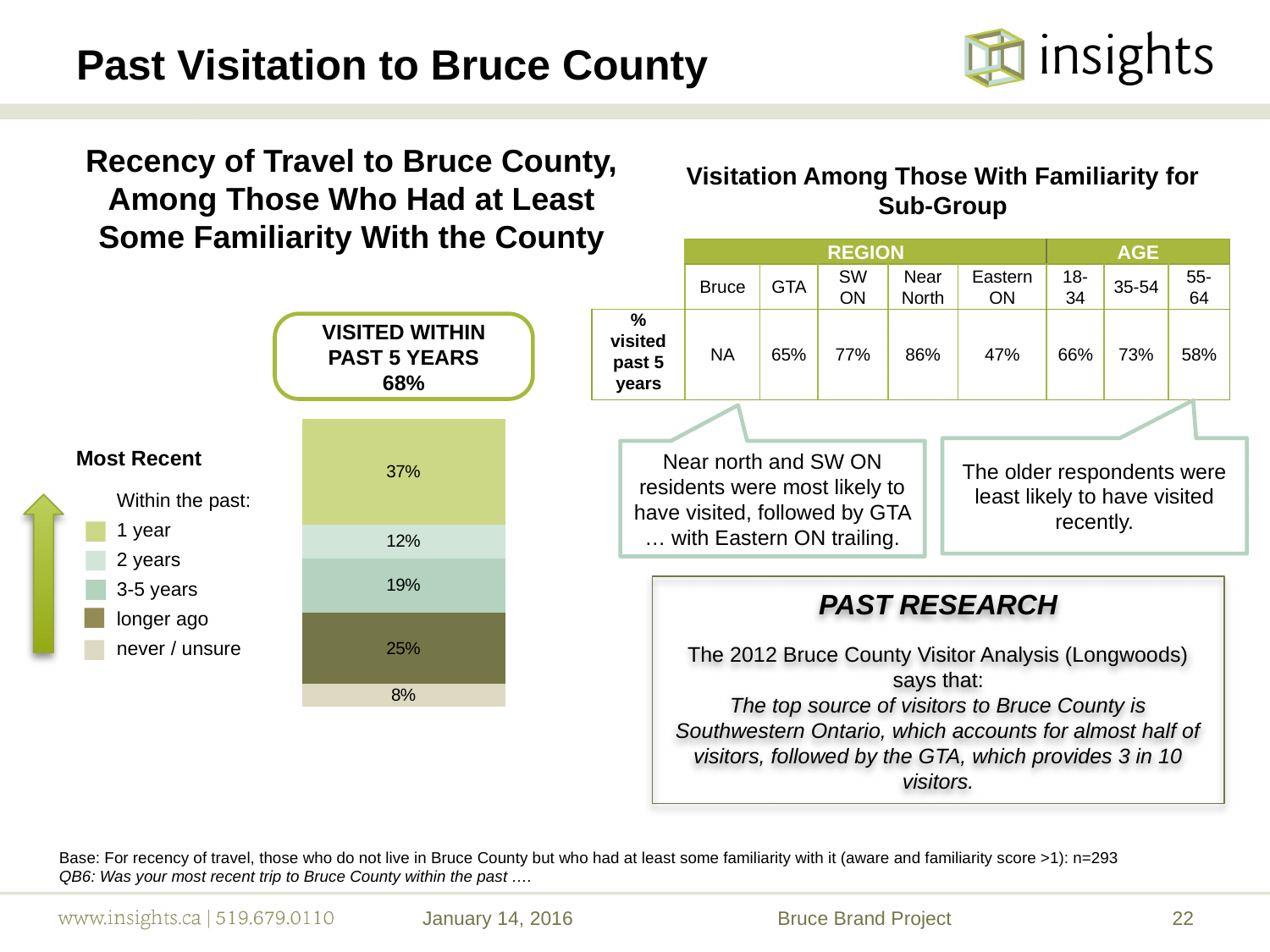
What kind of chart is used to show recency of travel to Bruce County? Stacked bar chart In the stacked bar chart, what percentage of respondents made their most recent trip within the past 3-5 years? 19% In the stacked bar chart, what percentage of respondents made their most recent trip longer ago? 25% How many segments make up the stacked bar? 5 According to the callout above the stacked bar, what percentage visited within the past 5 years? 68% What is the difference in percentage points between the '1 year' segment and the 'longer ago' segment? 12 percentage points Which segment of the stacked bar has the largest value? 1 year In the stacked bar chart, what percentage of respondents made their most recent trip to Bruce County within the past 1 year? 37% Which segment of the stacked bar has the smallest value? never / unsure In the stacked bar chart, what percentage of respondents made their most recent trip within the past 2 years? 12% Which is larger in the stacked bar: the '3-5 years' segment or the '2 years' segment? 3-5 years In the stacked bar chart, what percentage of respondents answered never / unsure? 8%